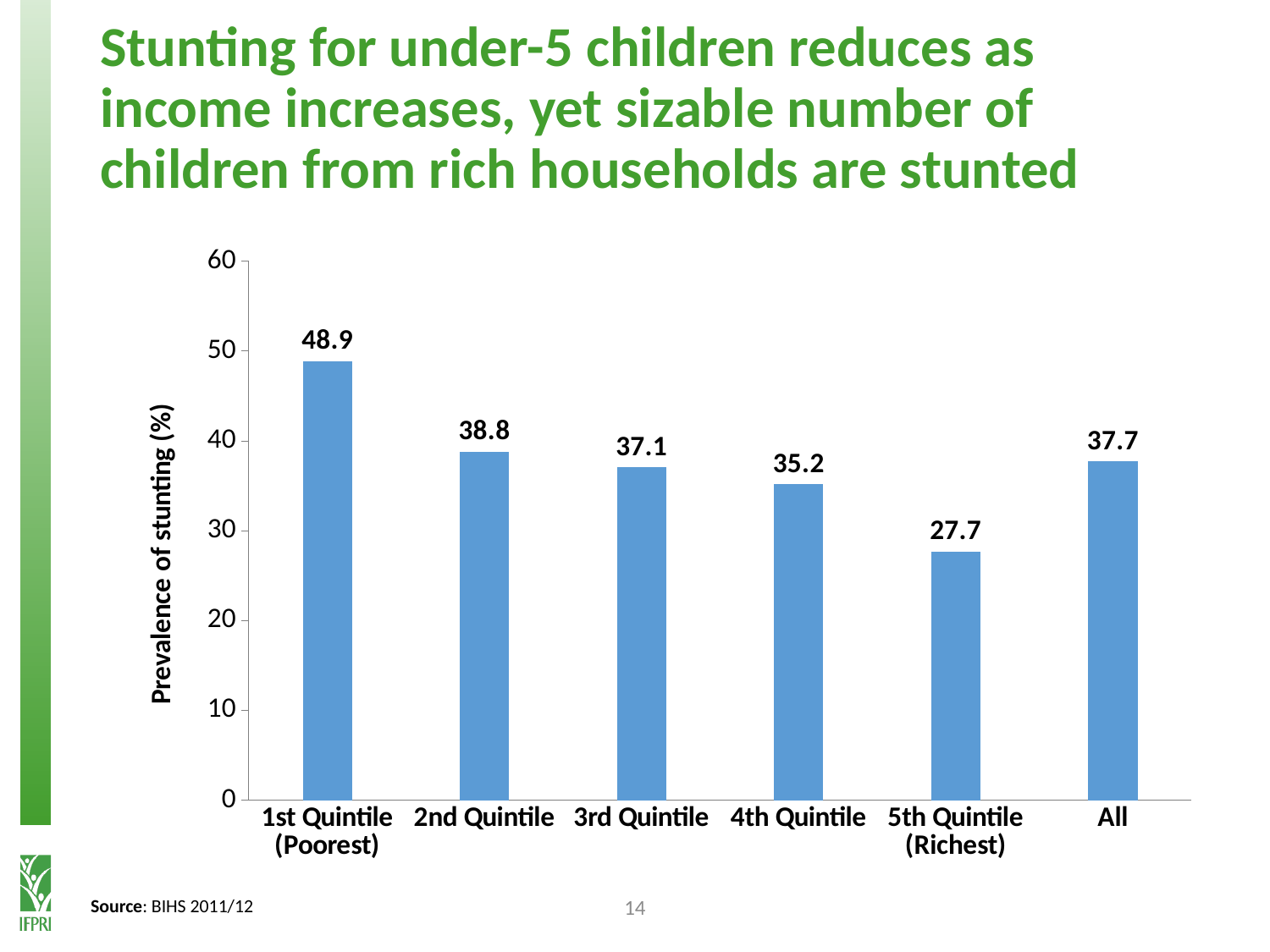
Which category has the lowest prevalence of stunting? 5th Quintile (Richest) What is the difference in prevalence of stunting between the 2nd Quintile and the 4th Quintile? 3.6 How many categories are shown on the x axis of the chart? 6 Do the values rise or fall from the 1st Quintile to the 5th Quintile? Fall What is the prevalence of stunting for the 5th Quintile (Richest)? 27.7 Which category has the highest prevalence of stunting? 1st Quintile (Poorest) What kind of chart is shown on the slide? Bar chart What is the difference in prevalence of stunting between the 1st Quintile (Poorest) and the 5th Quintile (Richest)? 21.2 What is the prevalence of stunting for the 1st Quintile (Poorest)? 48.9 What is the prevalence of stunting for the All category? 37.7 Which has a higher prevalence of stunting, the 2nd Quintile or the All category? 2nd Quintile What is the prevalence of stunting for the 3rd Quintile? 37.1